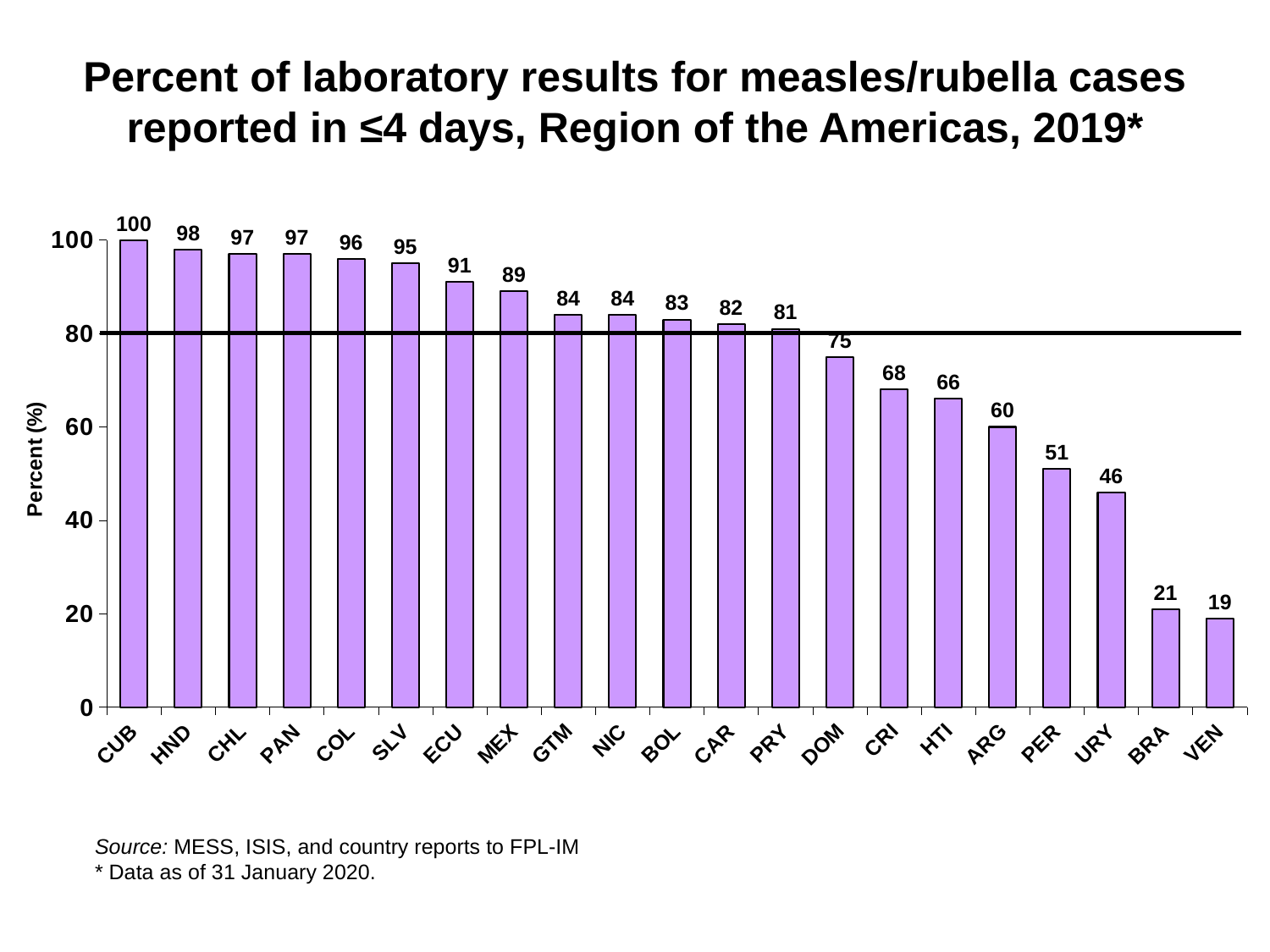
What is the value for MEX? 89 Which country has the highest value? CUB What is the difference between the values for CRI and HTI? 2 What is the label of the y axis? Percent (%) How many countries are shown on the chart? 21 What is the difference between the values for CUB and VEN? 81 Which country has the lowest value? VEN Is the value for BRA greater or less than 40? less What kind of chart is shown on the slide? bar chart What is the value for URY? 46 What is the value for DOM? 75 Which is larger, the value for ARG or the value for PER? ARG